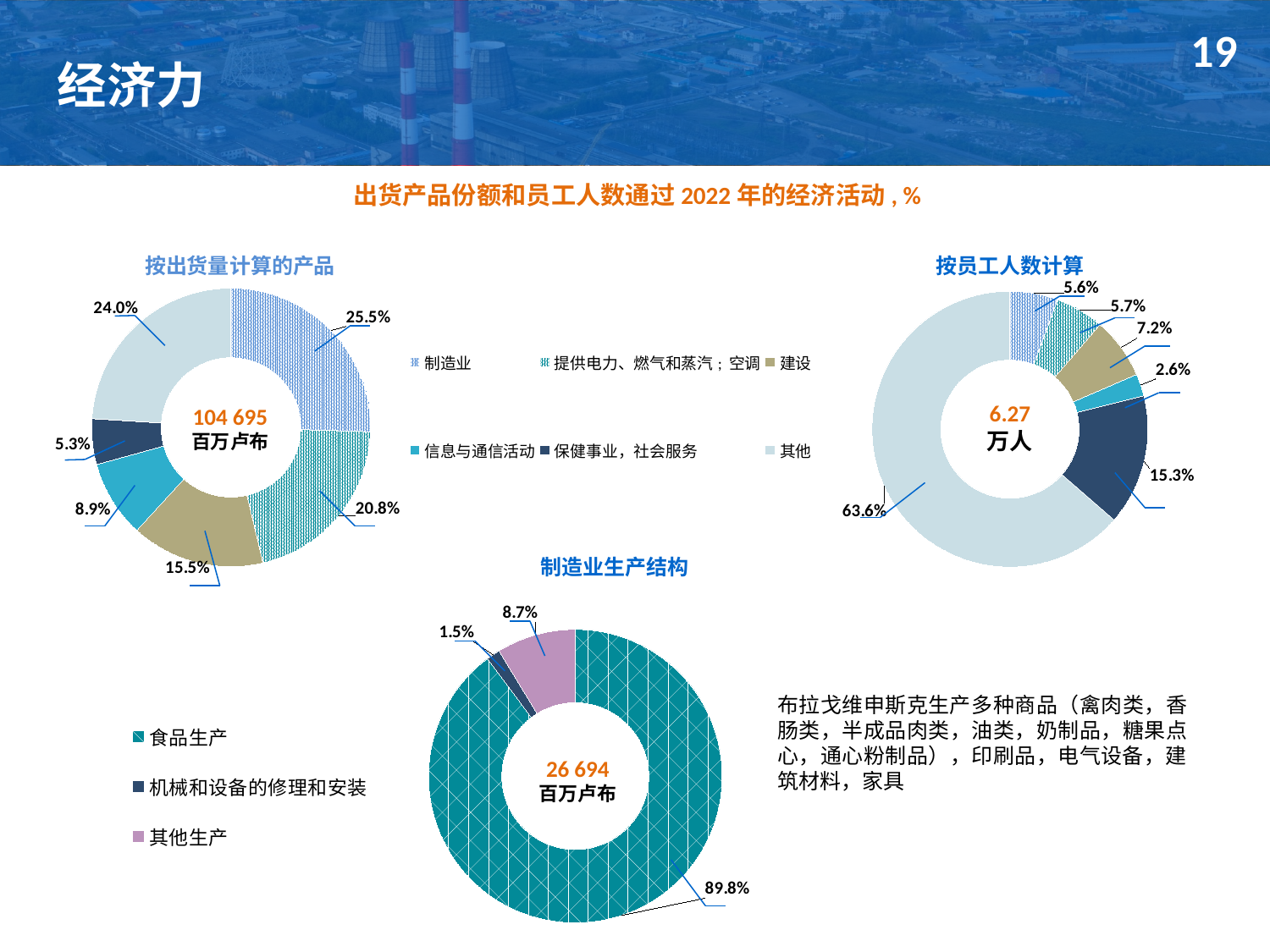
In the chart titled 按出货量计算的产品, what is the share for 建设? 15.5% How many legend entries are shared by the charts 按出货量计算的产品 and 按员工人数计算? 6 In the chart titled 按出货量计算的产品, what total value is shown in the centre of the donut? 104 695 百万卢布 In the chart titled 按出货量计算的产品, what is the difference between the shares of 制造业 and 其他? 1.5% What kind of chart is the chart titled 制造业生产结构? Donut (pie) chart In the chart titled 按出货量计算的产品, what is the share for 制造业? 25.5% In the chart titled 按出货量计算的产品, which category has the smallest share? 保健事业，社会服务 In the chart titled 按员工人数计算, what is the share for 保健事业，社会服务? 15.3% In the chart titled 制造业生产结构, what is the share for 食品生产? 89.8% In the chart titled 按员工人数计算, which category has the largest share? 其他 In the chart titled 按员工人数计算, which is larger: the share for 建设 or the share for 信息与通信活动? 建设 In the chart titled 制造业生产结构, how many categories are shown? 3